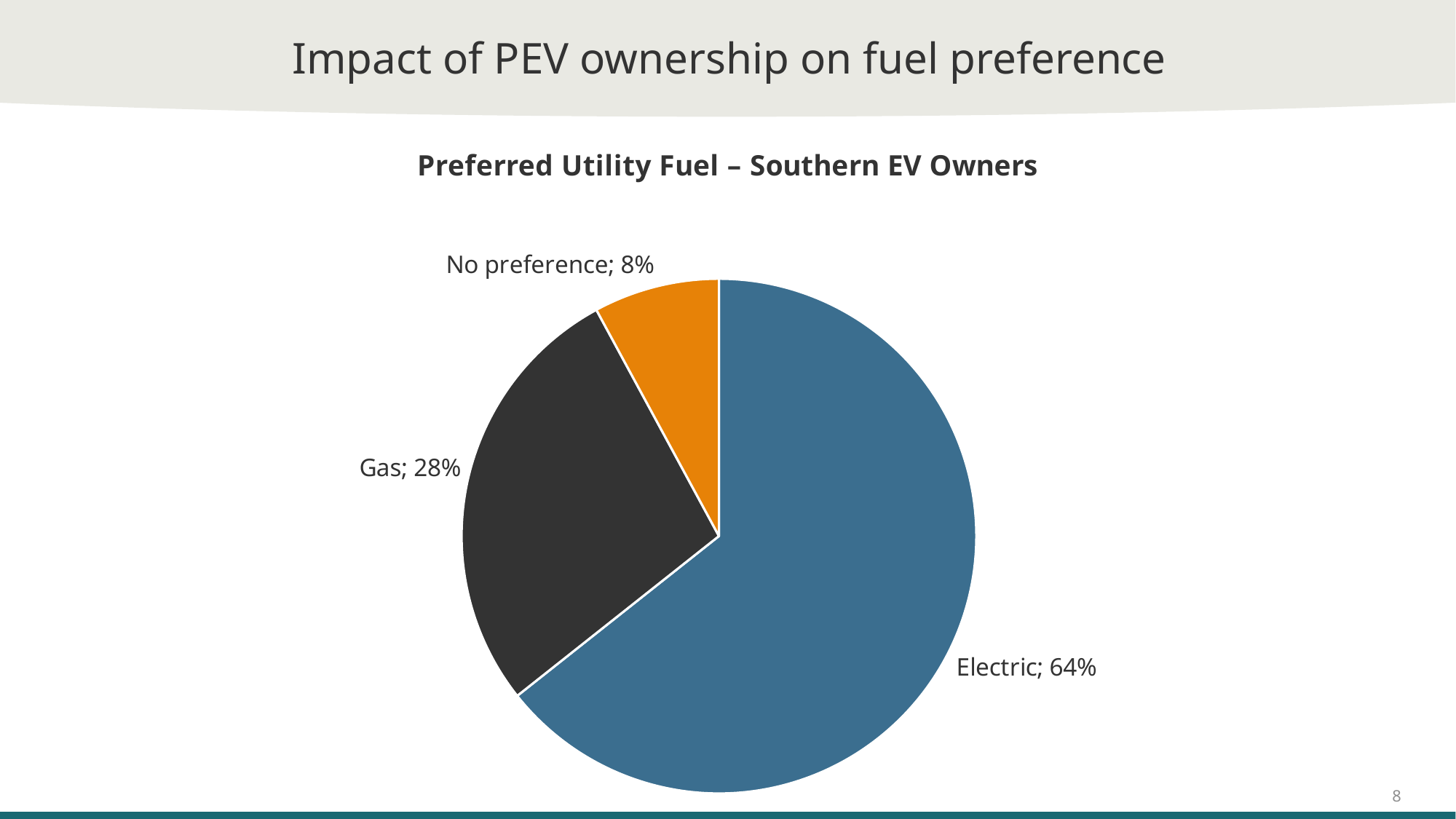
What share of Southern EV owners prefer Gas? 28% What share of Southern EV owners prefer Electric? 64% What kind of chart is shown on the slide? pie chart Which category has the smallest slice of the pie? No preference What colour is the Electric slice of the pie? blue What is the difference in percentage points between Electric and Gas? 36 Which is larger, the share for Gas or the share for No preference? Gas What is the difference in percentage points between Gas and No preference? 20 How many slices does the pie chart have? 3 Which fuel preference has the largest slice of the pie? Electric What share of Southern EV owners have No preference? 8% What is the title of the chart? Preferred Utility Fuel – Southern EV Owners